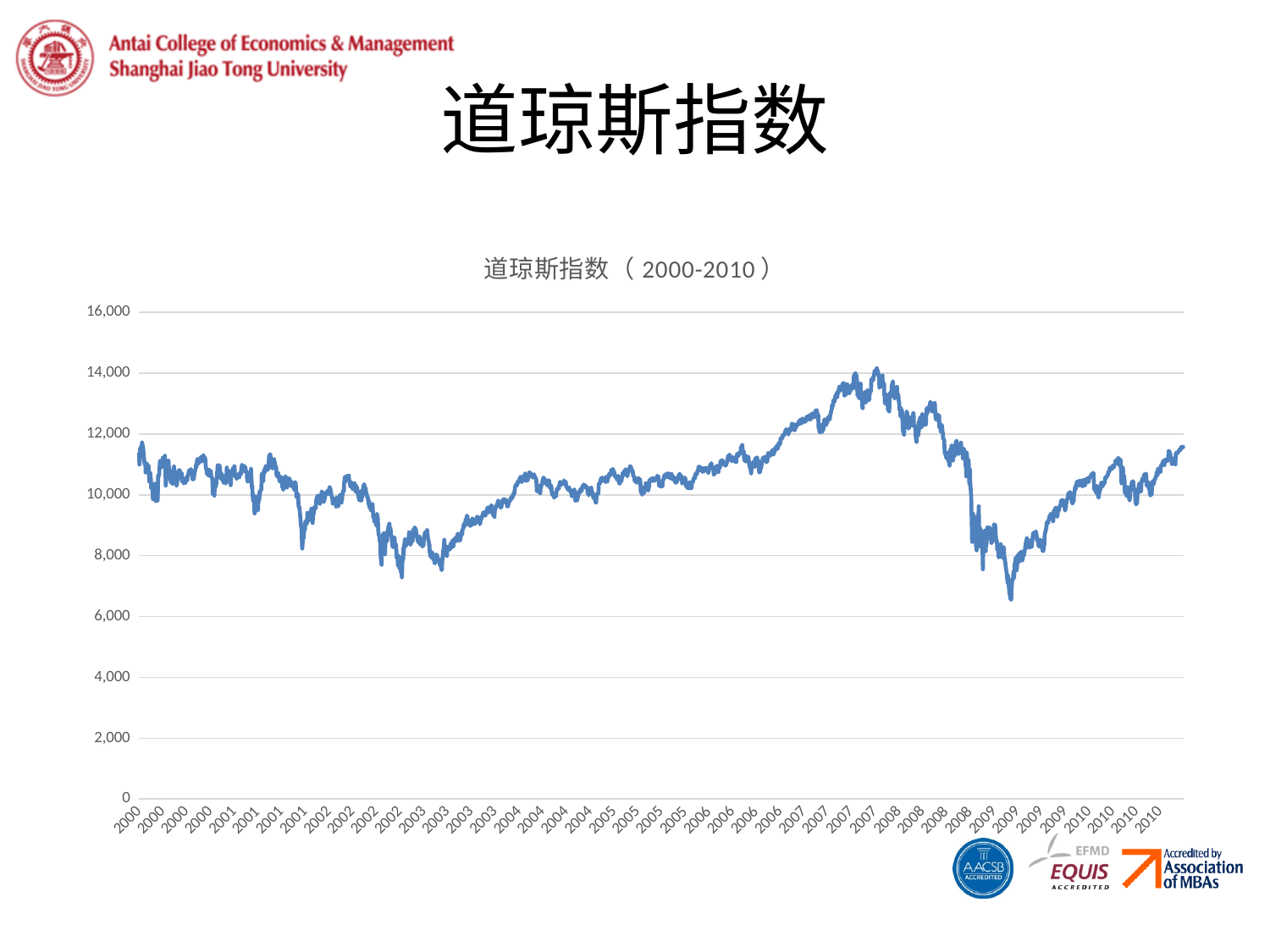
Is the index higher at its 2007 peak or at its 2009 low? 2007 peak Is the value of the index at the end of 2010 greater or less than 10,000? greater What is the title of the chart? 道琼斯指数（2000-2010） In which year does the index reach its highest point on the chart? 2007 What kind of chart is shown on the slide? line chart Is the peak value of the index in 2007 greater or less than 12,000? greater Does the index generally rise or fall between late 2007 and early 2009? fall What is the highest value shown on the vertical axis of the chart? 16,000 In which year does the index reach its lowest point on the chart? 2009 Is the value of the index at the start of 2000 greater or less than 10,000? greater Does the index generally rise or fall between 2003 and 2007? rise